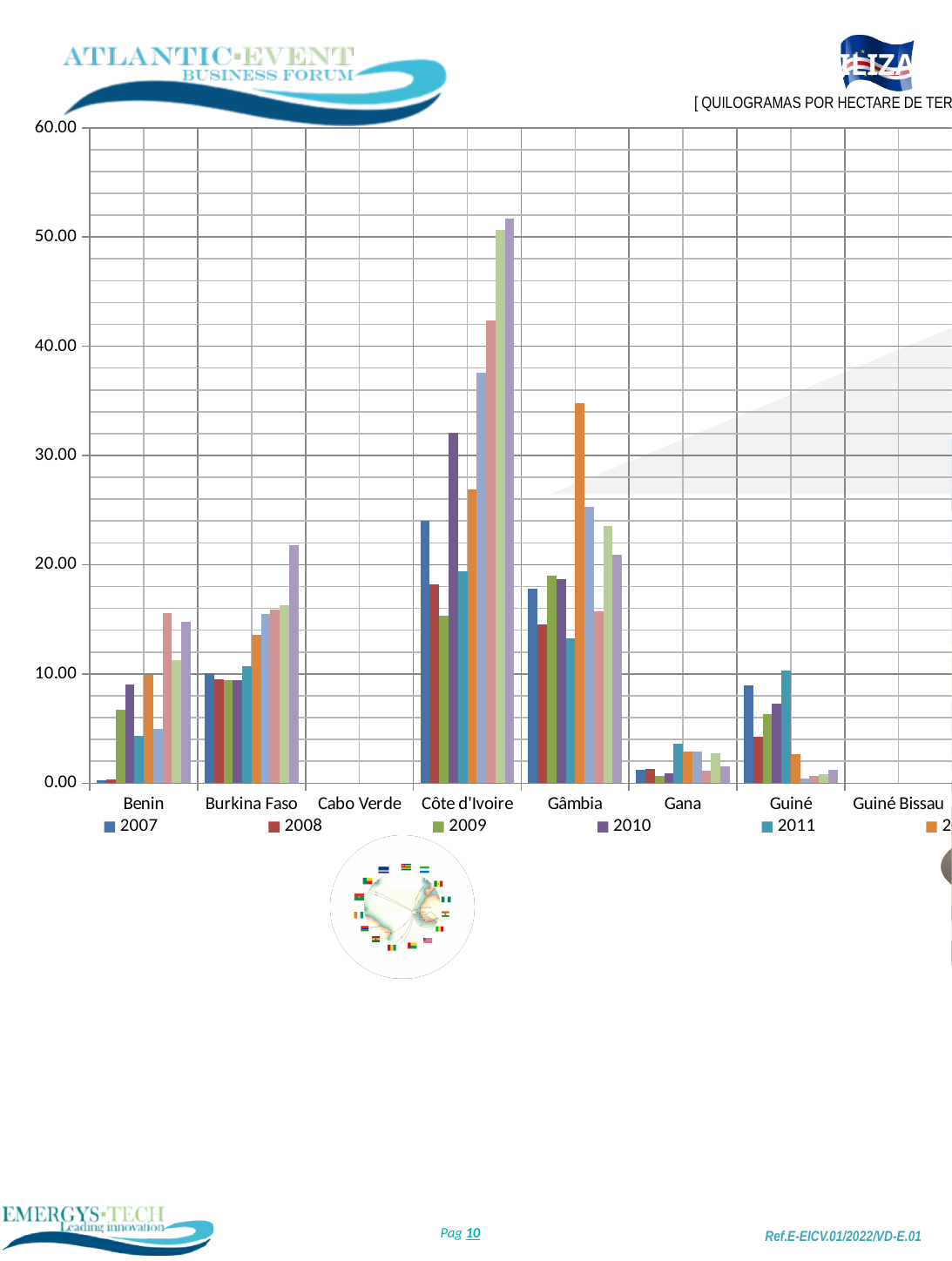
Which country has the tallest bar in the chart? Côte d'Ivoire What kind of chart is shown on the slide? bar chart Is the 2009 value for Gâmbia greater or less than 10? greater Which is larger, the 2009 value for Benin or the 2009 value for Burkina Faso? Burkina Faso Is the 2008 value for Guiné greater or less than 10? less What is the highest value shown on the y axis? 60.00 For Côte d'Ivoire, which is larger, the 2007 value or the 2010 value? 2010 Is the 2010 value for Côte d'Ivoire greater or less than 30? greater How many country categories are labelled on the x axis? 8 Which is larger, the 2007 value for Côte d'Ivoire or the 2007 value for Gâmbia? Côte d'Ivoire